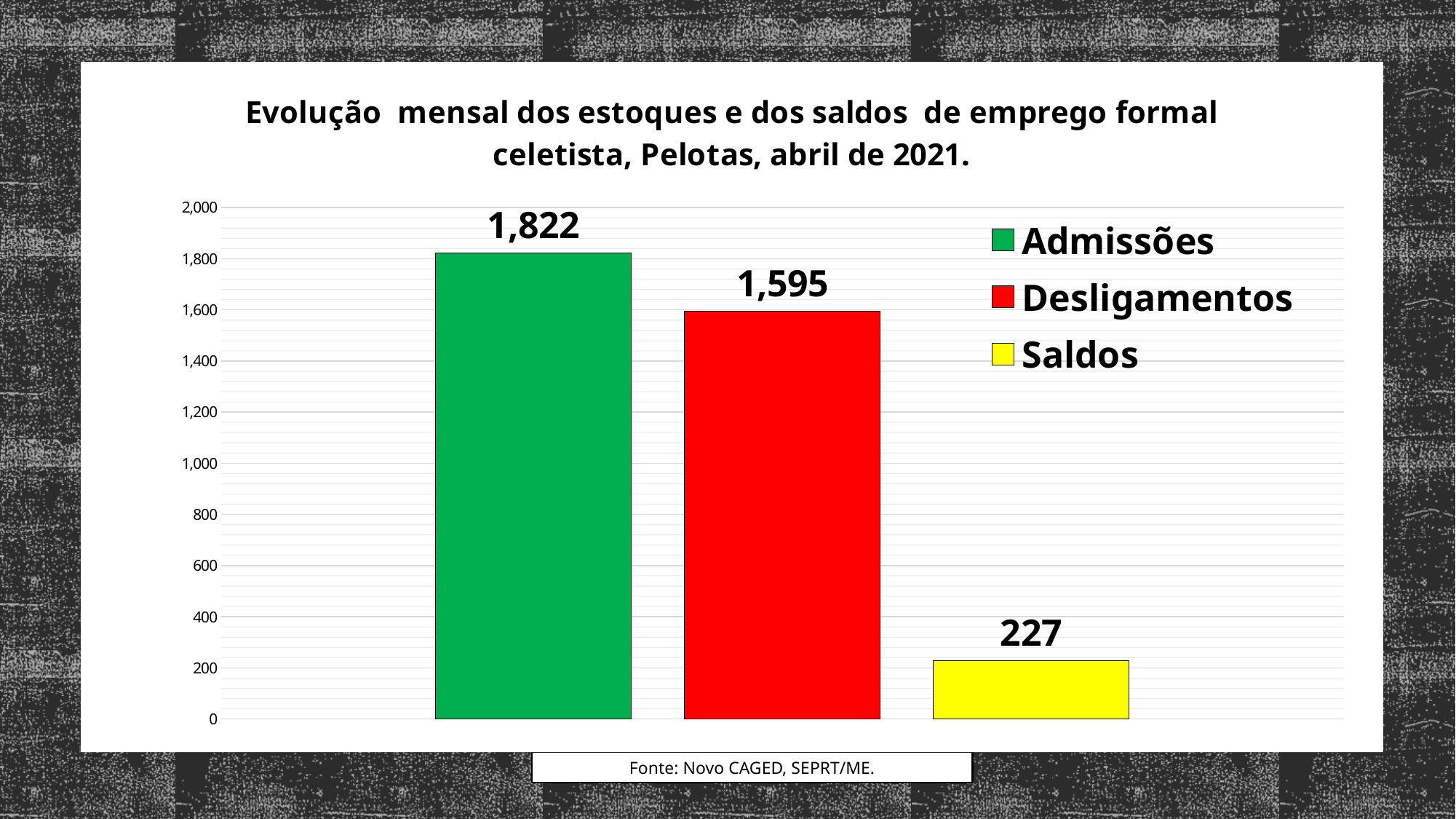
How many series does the legend list? 3 Which series has the highest value? Admissões Is the value for Desligamentos greater or less than 1,400? greater What colour is the bar for Saldos? yellow What is the difference between Admissões and Desligamentos? 227 What is the value for Desligamentos? 1,595 Which is larger, Desligamentos or Saldos? Desligamentos What is the value for Admissões? 1,822 How many bars are plotted in the chart? 3 What kind of chart is shown on the slide? bar chart Which series has the lowest value? Saldos What is the value for Saldos? 227